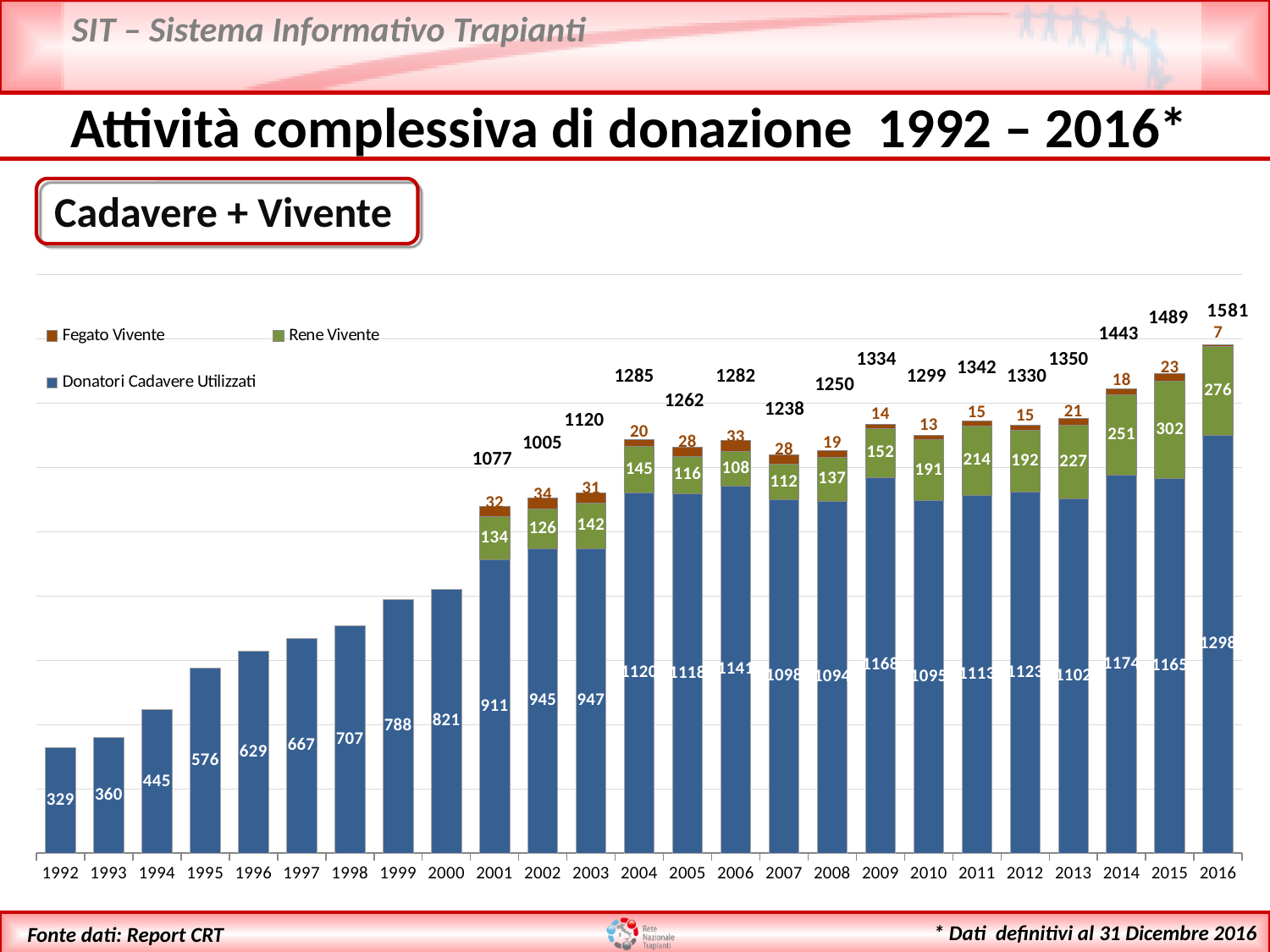
What is the difference between the Donatori Cadavere Utilizzati values for 2016 and 2015? 133 In which year is the Donatori Cadavere Utilizzati value lowest? 1992 In which year is the Rene Vivente value highest? 2015 How many years are shown on the x axis? 25 What kind of chart is shown on the slide? Stacked bar chart What is the total of the stacked bar for 2016? 1581 What is the value of Fegato Vivente in 2016? 7 What is the value of Rene Vivente in 2015? 302 How many series does the chart legend list? 3 Which year has the larger Rene Vivente value, 2012 or 2013? 2013 Do the Donatori Cadavere Utilizzati values rise or fall from 1992 to 2000? Rise What is the value of Donatori Cadavere Utilizzati in 1992? 329